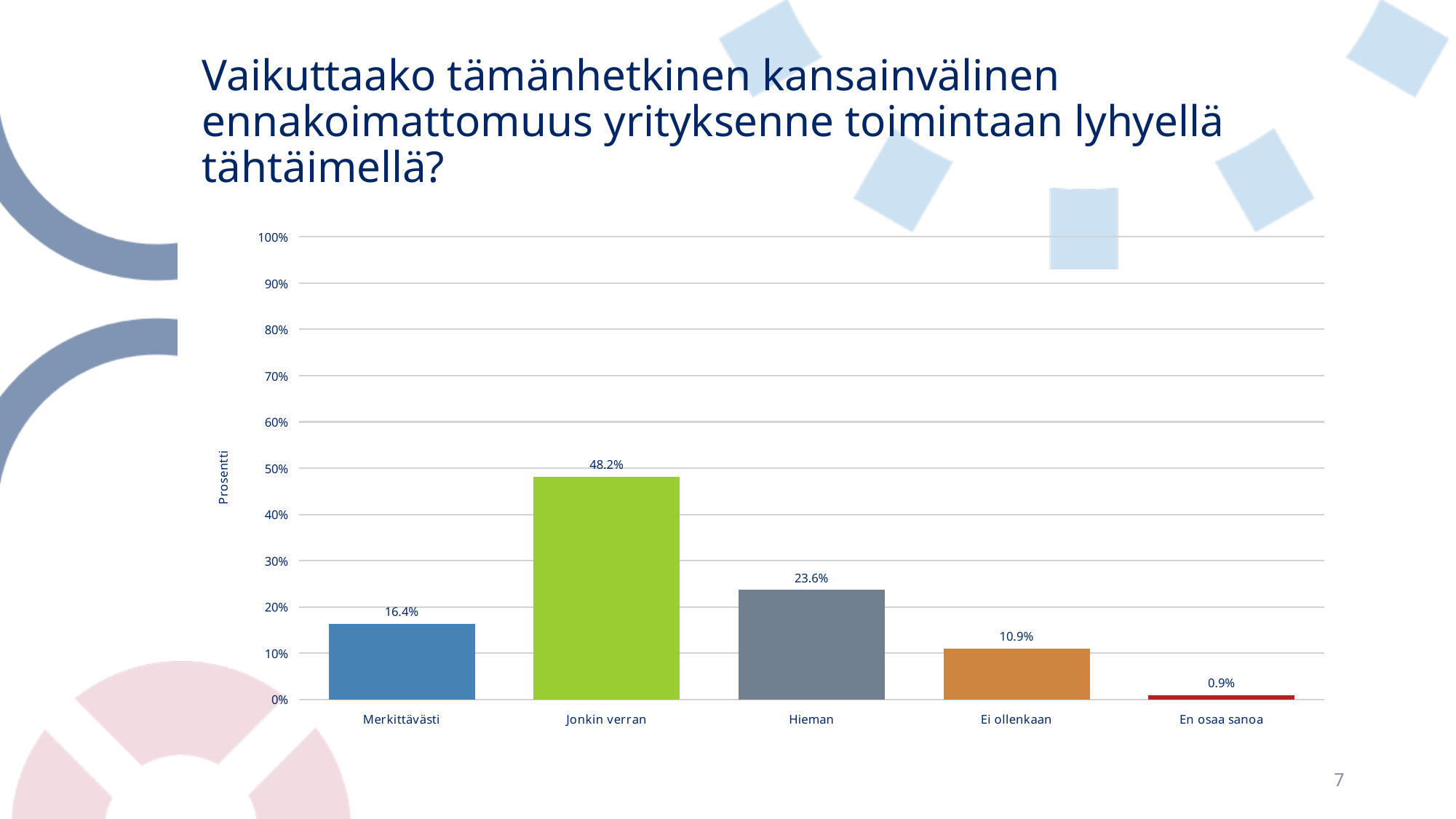
Which category has the lowest value? En osaa sanoa How many categories are shown on the x axis? 5 Which category has the highest value? Jonkin verran What colour is the bar for Jonkin verran? Green Is the value for Hieman greater or less than 20%? greater What is the value for En osaa sanoa? 0.9% What is the value for Merkittävästi? 16.4% What is the label of the y axis? Prosentti What is the difference between the values for Jonkin verran and Hieman? 24.6% What is the value for Jonkin verran? 48.2% Which is larger, the value for Merkittävästi or the value for Ei ollenkaan? Merkittävästi What kind of chart is shown on the slide? Bar chart